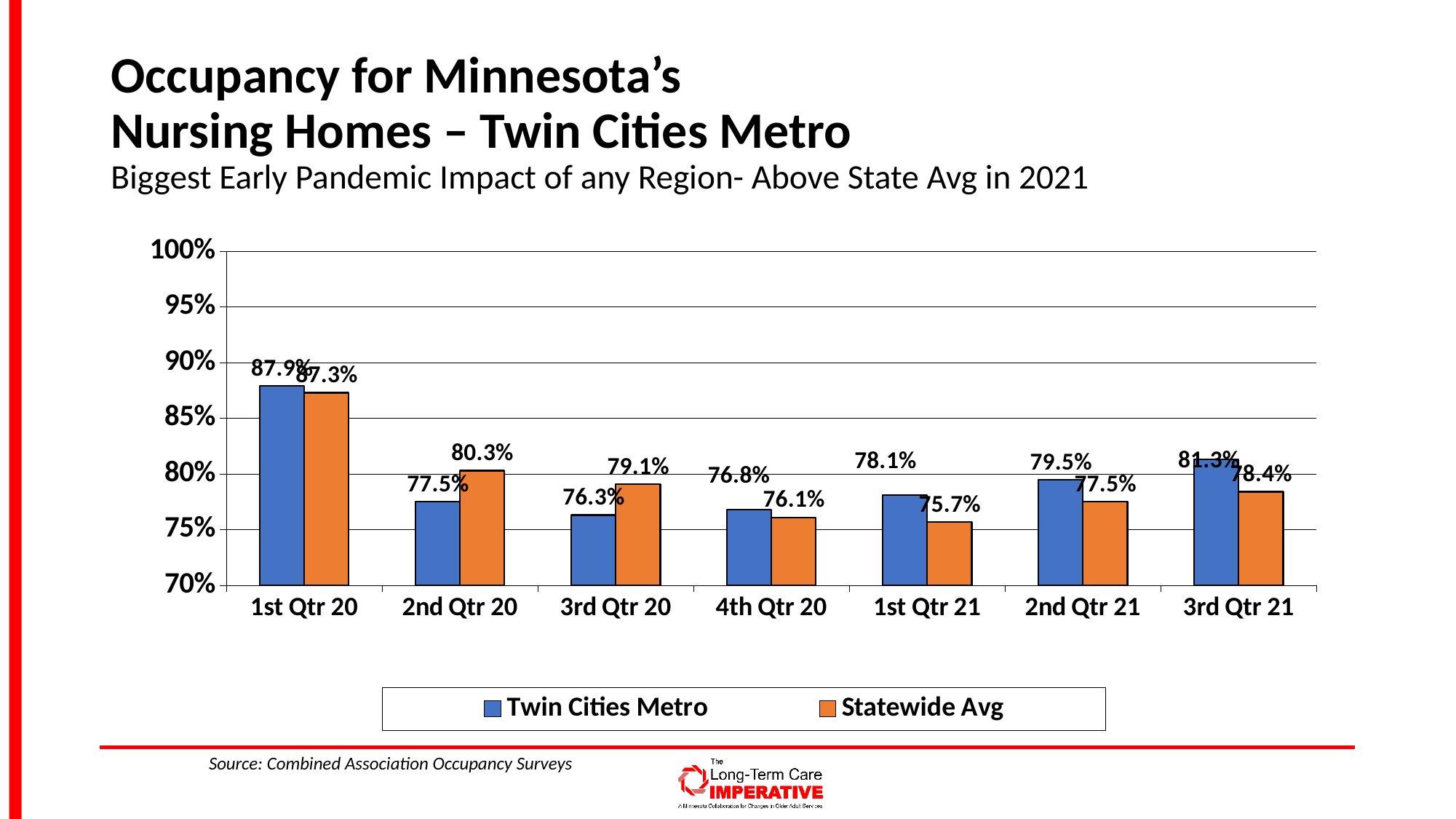
How many series does the legend list? 2 Does the Twin Cities Metro occupancy rise or fall from 3rd Qtr 20 to 3rd Qtr 21? Rise What is the Statewide Avg occupancy value for 3rd Qtr 20? 79.1% What is the Twin Cities Metro occupancy value for 2nd Qtr 20? 77.5% In 1st Qtr 21, which is larger: Twin Cities Metro or Statewide Avg? Twin Cities Metro In which quarter is the Twin Cities Metro occupancy lowest? 3rd Qtr 20 What kind of chart is shown on the slide? Bar chart How many quarters are shown on the x axis? 7 What is the Twin Cities Metro occupancy value for 1st Qtr 21? 78.1% In which quarter is the Statewide Avg occupancy highest? 1st Qtr 20 In 2nd Qtr 20, how many percentage points higher is the Statewide Avg than the Twin Cities Metro? 2.8 percentage points What is the Statewide Avg occupancy value for 4th Qtr 20? 76.1%